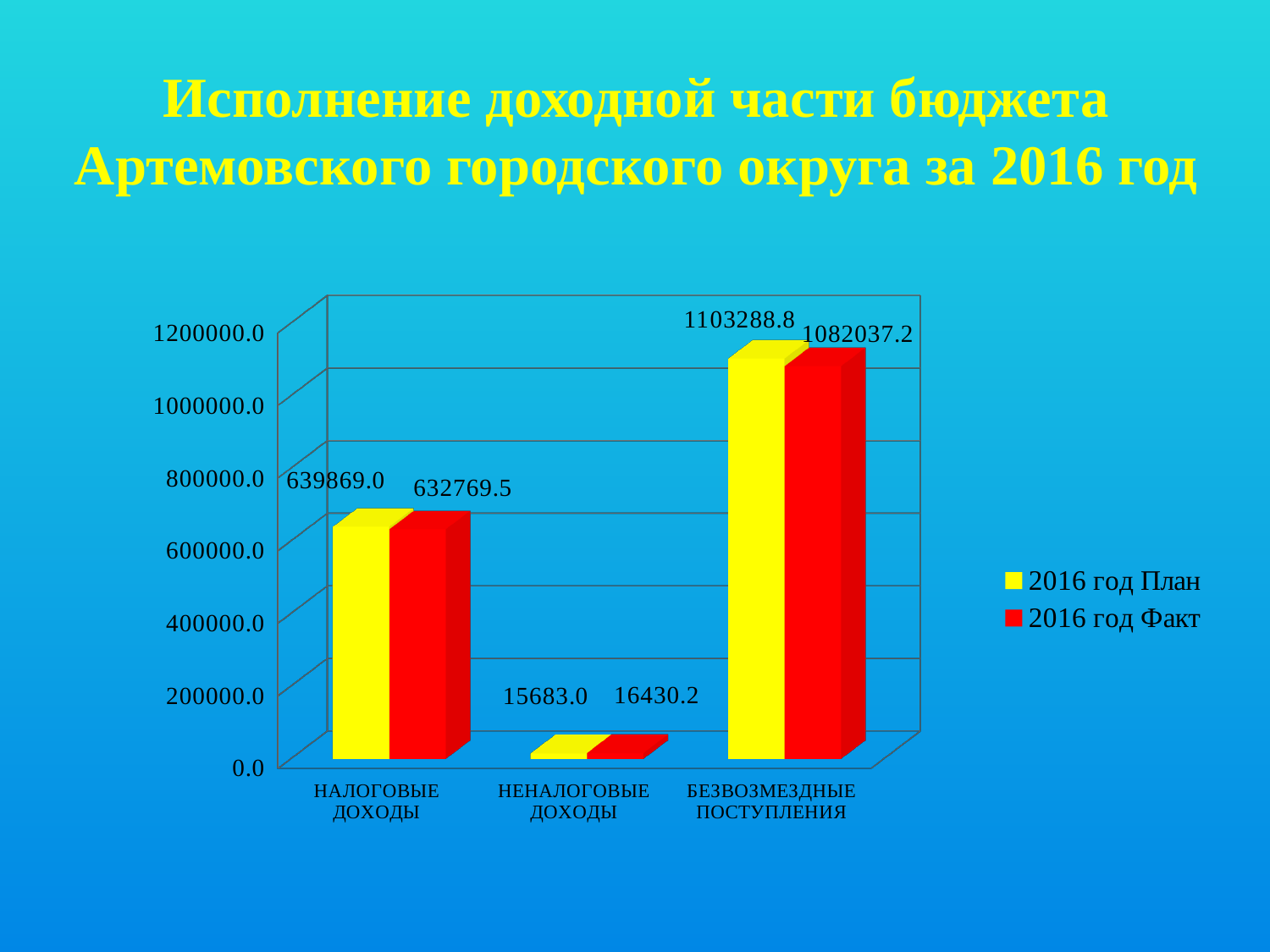
What is the difference between the 2016 год План and 2016 год Факт values for НАЛОГОВЫЕ ДОХОДЫ? 7099.5 What is the 2016 год Факт value for БЕЗВОЗМЕЗДНЫЕ ПОСТУПЛЕНИЯ? 1082037.2 For НЕНАЛОГОВЫЕ ДОХОДЫ, which is larger: the 2016 год План value or the 2016 год Факт value? 2016 год Факт What is the 2016 год План value for НАЛОГОВЫЕ ДОХОДЫ? 639869.0 How many categories are shown on the x axis of the chart? 3 What kind of chart is shown on the slide? bar chart Which category has the lowest 2016 год Факт value? НЕНАЛОГОВЫЕ ДОХОДЫ What is the 2016 год Факт value for НЕНАЛОГОВЫЕ ДОХОДЫ? 16430.2 Which category has the highest 2016 год План value? БЕЗВОЗМЕЗДНЫЕ ПОСТУПЛЕНИЯ Is the 2016 год Факт value for НАЛОГОВЫЕ ДОХОДЫ greater or less than 800000.0? less How many series does the legend list? 2 What is the difference between the 2016 год План and 2016 год Факт values for БЕЗВОЗМЕЗДНЫЕ ПОСТУПЛЕНИЯ? 21251.6